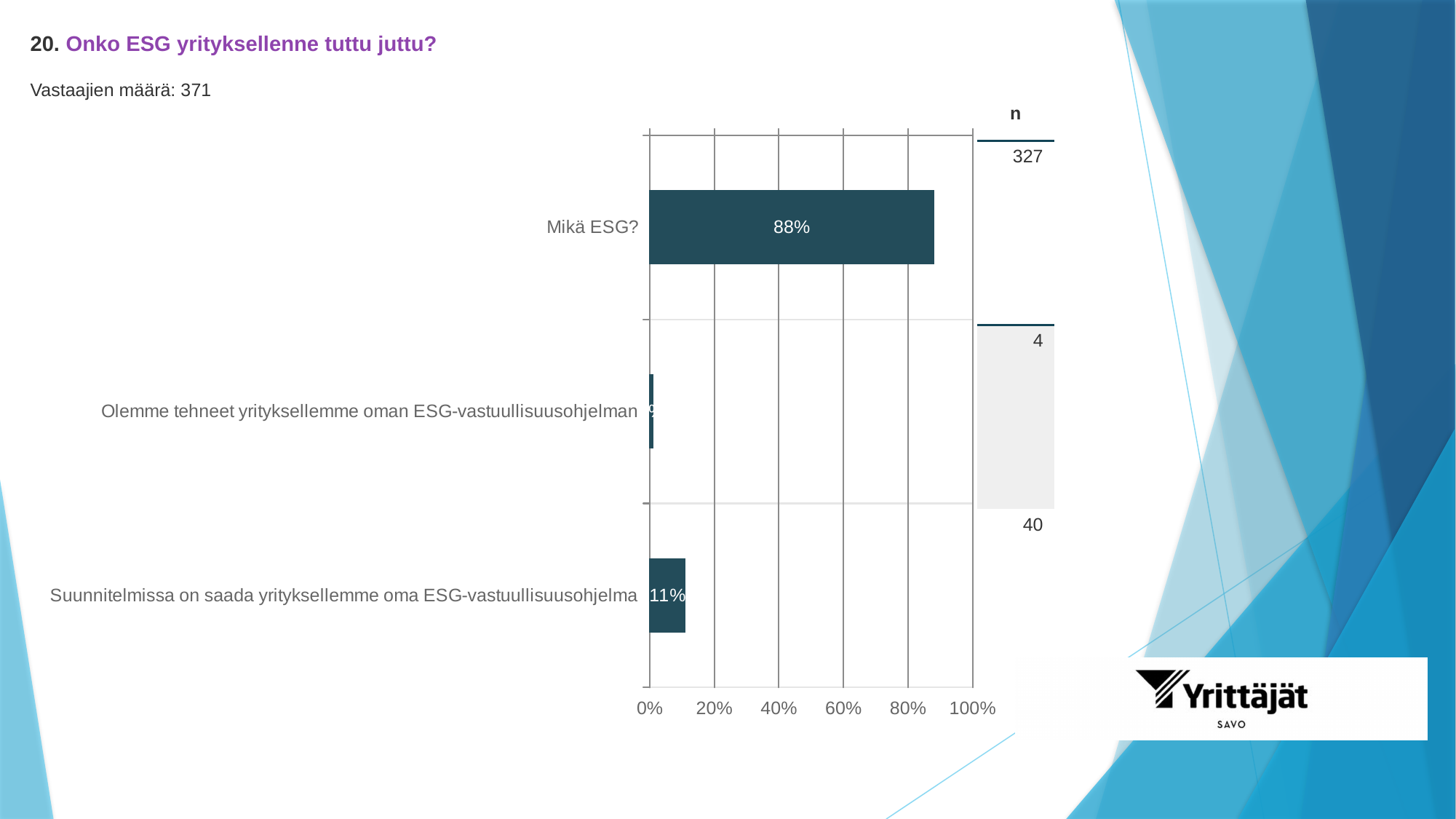
How many categories does the chart show? 3 What is the n value shown for "Olemme tehneet yrityksellemme oman ESG-vastuullisuusohjelman"? 4 Which category has the lowest percentage? Olemme tehneet yrityksellemme oman ESG-vastuullisuusohjelman Is the value for "Olemme tehneet yrityksellemme oman ESG-vastuullisuusohjelman" greater or less than 20%? less What percentage is shown for "Mikä ESG?"? 88% What is the n value shown for "Suunnitelmissa on saada yrityksellemme oma ESG-vastuullisuusohjelma"? 40 What percentage is shown for "Suunnitelmissa on saada yrityksellemme oma ESG-vastuullisuusohjelma"? 11% Which has a larger n value: "Suunnitelmissa on saada yrityksellemme oma ESG-vastuullisuusohjelma" or "Olemme tehneet yrityksellemme oman ESG-vastuullisuusohjelman"? Suunnitelmissa on saada yrityksellemme oma ESG-vastuullisuusohjelma What kind of chart is shown on the slide? Bar chart What is the difference in percentage points between "Mikä ESG?" and "Suunnitelmissa on saada yrityksellemme oma ESG-vastuullisuusohjelma"? 77 percentage points Which category has the highest percentage? Mikä ESG? What is the n value shown for "Mikä ESG?"? 327